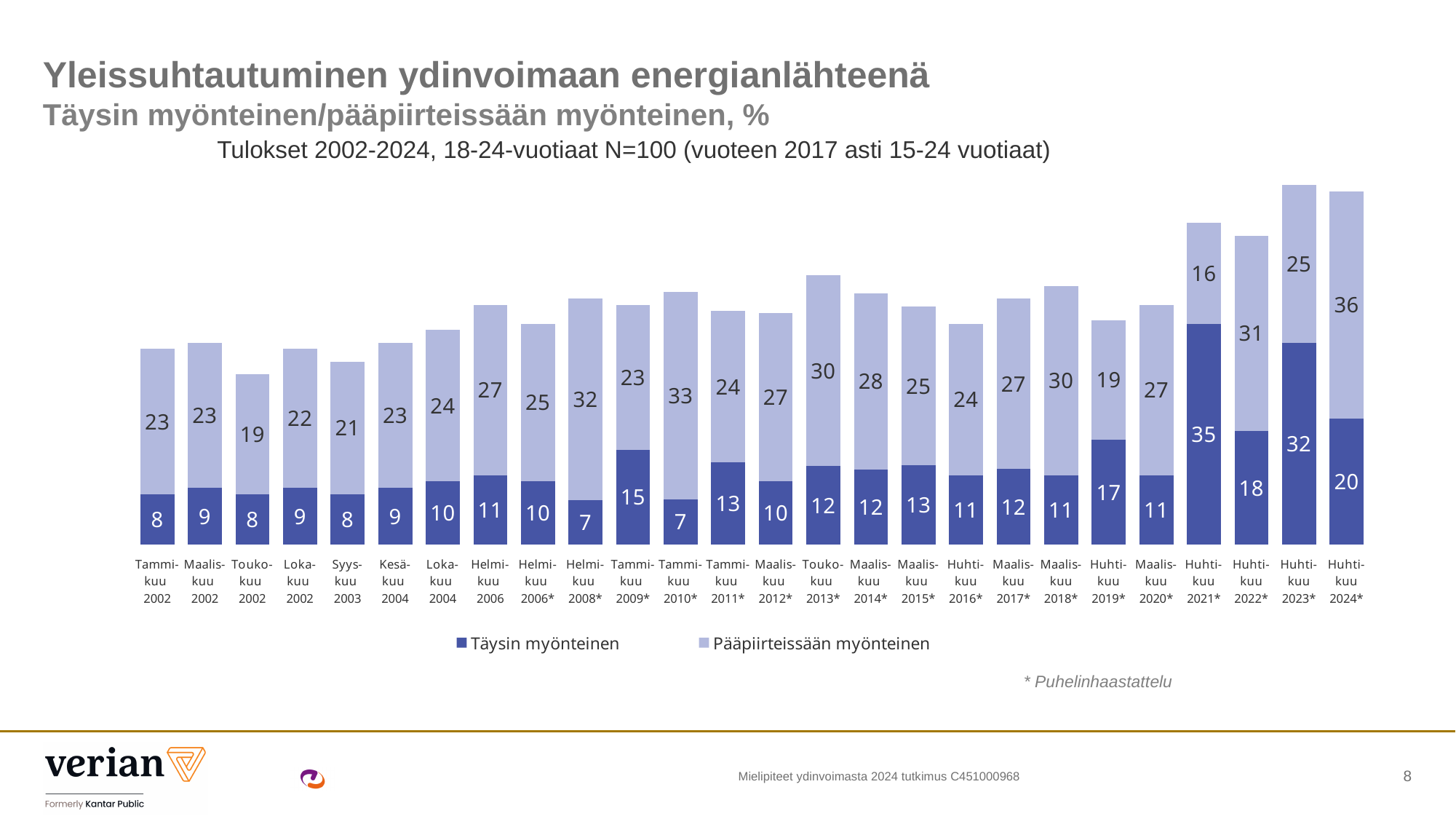
Which category has the lowest "Pääpiirteissään myönteinen" value? Huhtikuu 2021* How many categories (time points) are shown on the x axis? 26 How many series does the legend list? 2 What is the value of "Täysin myönteinen" for Huhtikuu 2021*? 35 What kind of chart is shown on the slide? Stacked bar chart What is the value of "Pääpiirteissään myönteinen" for Huhtikuu 2024*? 36 What is the difference between the "Täysin myönteinen" values for Huhtikuu 2021* and Huhtikuu 2022*? 17 Which category has the highest "Täysin myönteinen" value? Huhtikuu 2021* What is the total of the stacked bar for Huhtikuu 2023*? 57 What is the value of "Täysin myönteinen" for Tammikuu 2009*? 15 Which is larger: the "Pääpiirteissään myönteinen" value for Helmikuu 2008* or for Tammikuu 2009*? Helmikuu 2008* What is the total of the stacked bar for Huhtikuu 2024*? 56